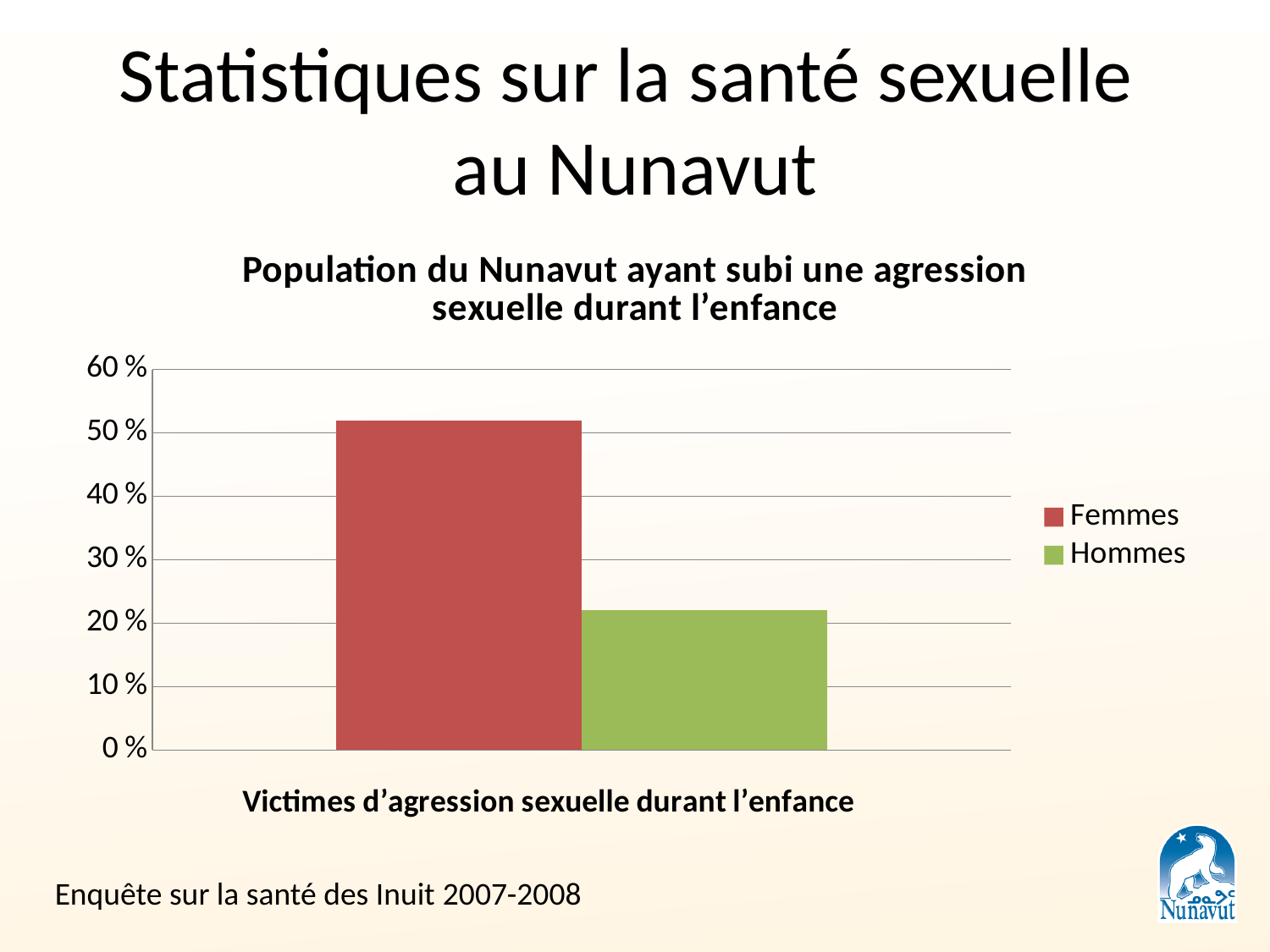
How many categories are shown on the x axis of the chart? 1 How many series does the legend list? 2 Which series has the higher value, Femmes or Hommes? Femmes Is the value for Hommes greater or less than 10 %? greater What kind of chart is shown on the slide? bar chart Which series has the lower value, Femmes or Hommes? Hommes Is the value for Femmes greater or less than 40 %? greater What colour is the bar for Hommes? green Is the value for Hommes greater or less than 30 %? less Is the value for Hommes larger or smaller than the value for Femmes? smaller What is the title of the chart? Population du Nunavut ayant subi une agression sexuelle durant l'enfance